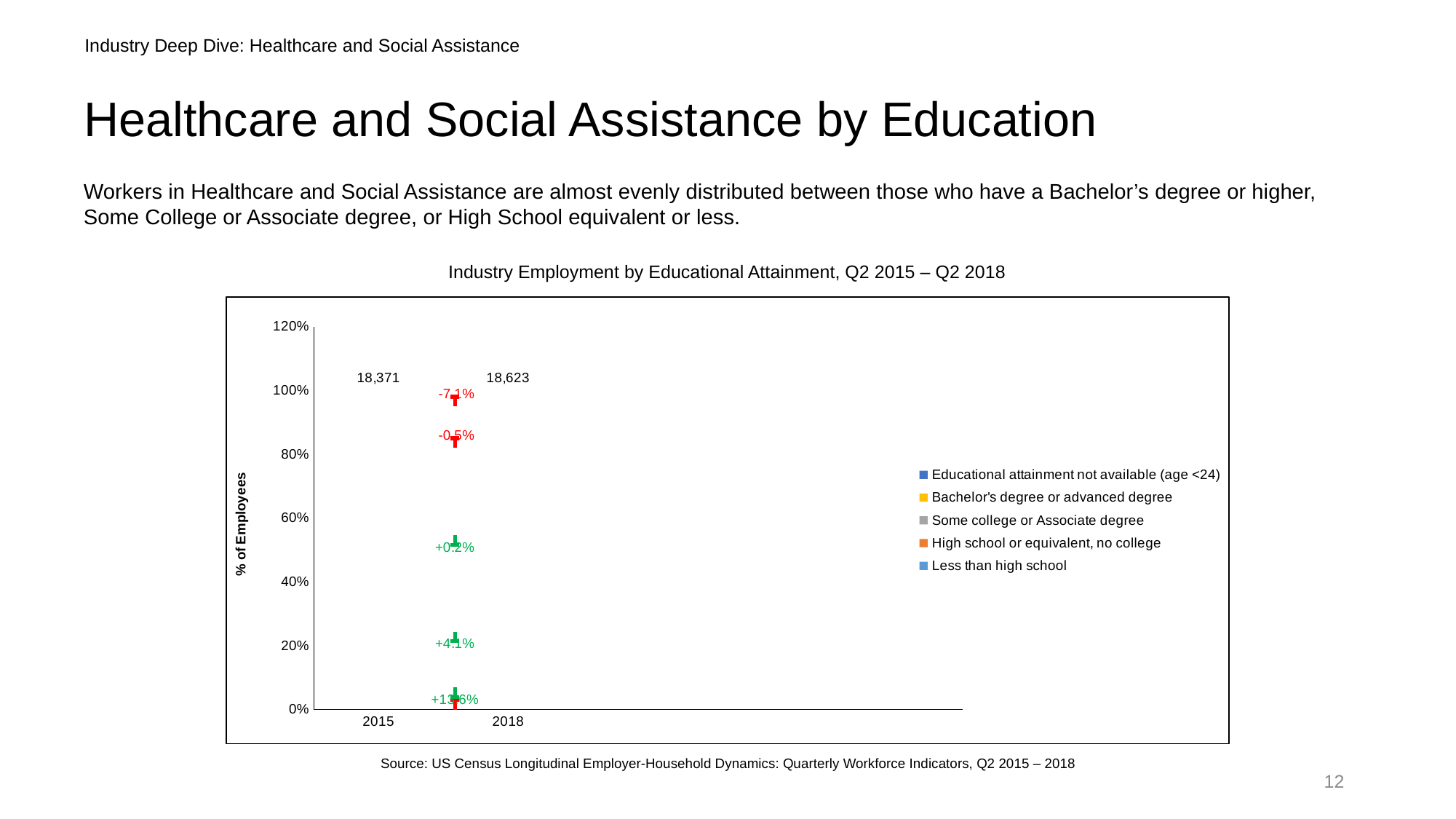
What total employee count is printed above the 2015 bar? 18,371 Which year has the larger printed total employee count, 2015 or 2018? 2018 What is the label on the y axis of the chart? % of Employees What is the difference between the printed total employee counts for 2018 and 2015? 252 What total employee count is printed above the 2018 bar? 18,623 How many series does the chart's legend list? 5 How many years are shown on the x axis of the chart? 2 Does the printed total employee count rise or fall from 2015 to 2018? rise What is the title of the chart? Industry Employment by Educational Attainment, Q2 2015 – Q2 2018